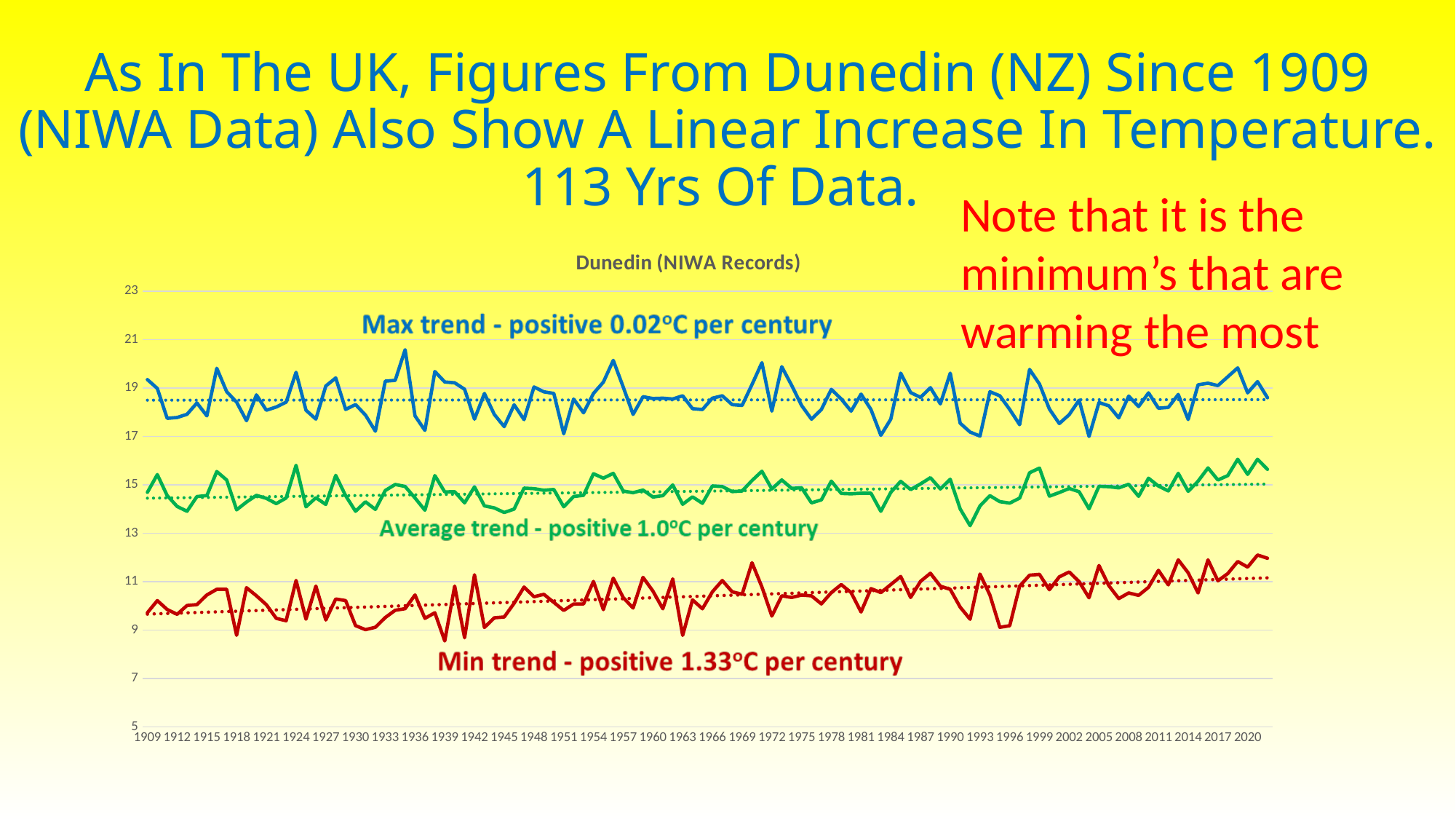
Is the Average value for 2020 greater or less than 15? greater What is the Max trend per century stated on the chart? positive 0.02°C per century What kind of chart is shown on the slide? line chart Does the Min (red) series rise or fall overall from 1909 to 2020? rise Which series has the smallest stated warming trend per century? Max Which series has the largest stated warming trend per century? Min What is the title of the chart? Dunedin (NIWA Records) What is the first year shown on the x axis? 1909 What is the Min trend per century stated on the chart? positive 1.33°C per century How many temperature series are plotted on the chart? 3 What is the Average trend per century stated on the chart? positive 1.0°C per century Is the Min value for 1918 greater or less than 10? less